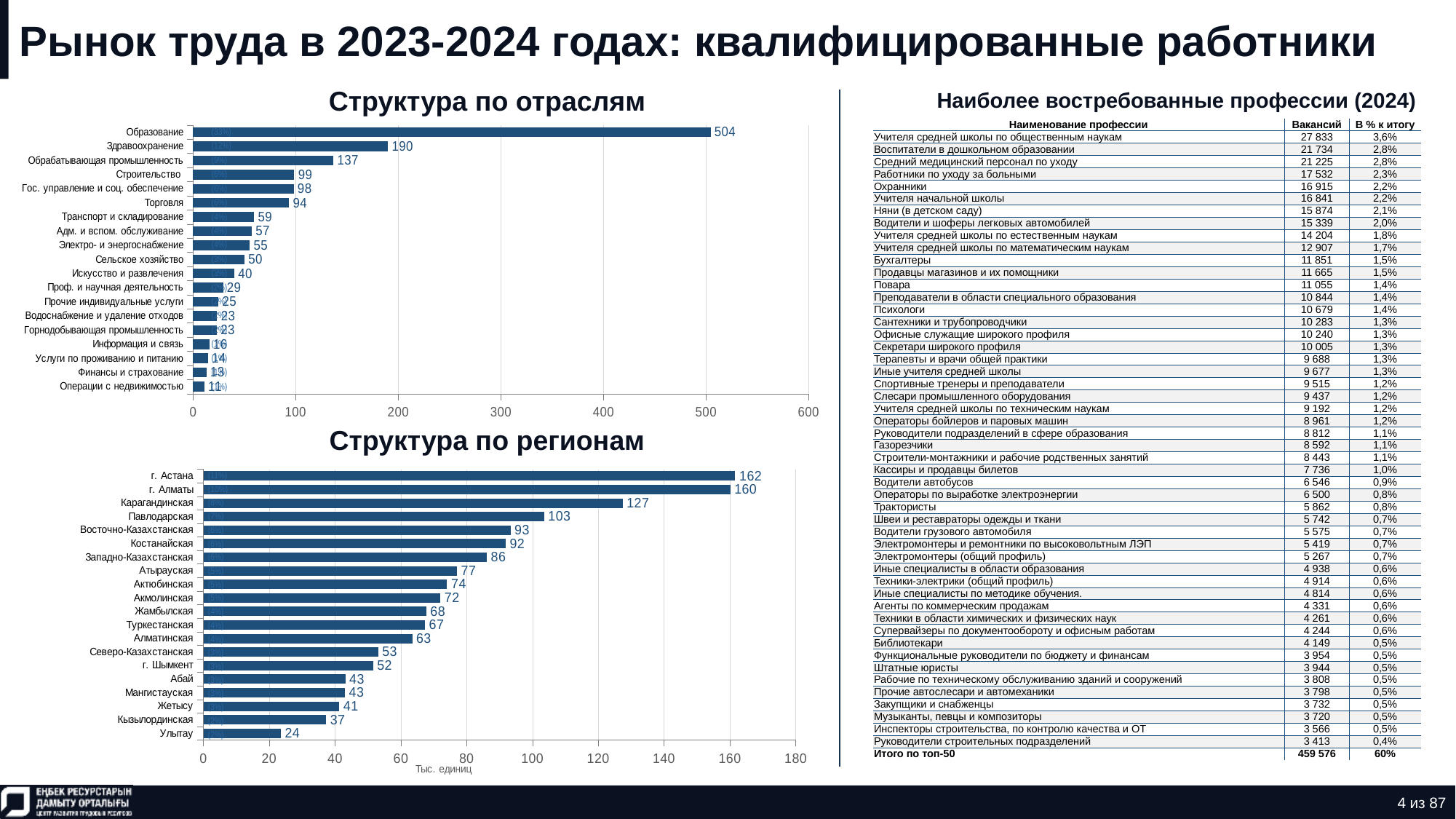
On the 'Структура по отраслям' chart, how many categories are shown? 19 On the 'Структура по регионам' chart, what is the value for Карагандинская? 127 On the 'Структура по отраслям' chart, what is the difference between Образование and Здравоохранение? 314 On the 'Структура по регионам' chart, which is larger: Павлодарская or Восточно-Казахстанская? Павлодарская What unit label is shown on the x axis of the 'Структура по регионам' chart? Тыс. единиц On the 'Структура по отраслям' chart, what is the value for Здравоохранение? 190 On the 'Структура по регионам' chart, which region has the lowest value? Улытау On the 'Структура по регионам' chart, what is the difference between г. Астана and г. Шымкент? 110 On the 'Структура по отраслям' chart, which category has the lowest value? Операции с недвижимостью On the 'Структура по регионам' chart, how many regions are shown? 20 What kind of chart is 'Структура по отраслям'? Bar chart On the 'Структура по отраслям' chart, which category has the highest value? Образование